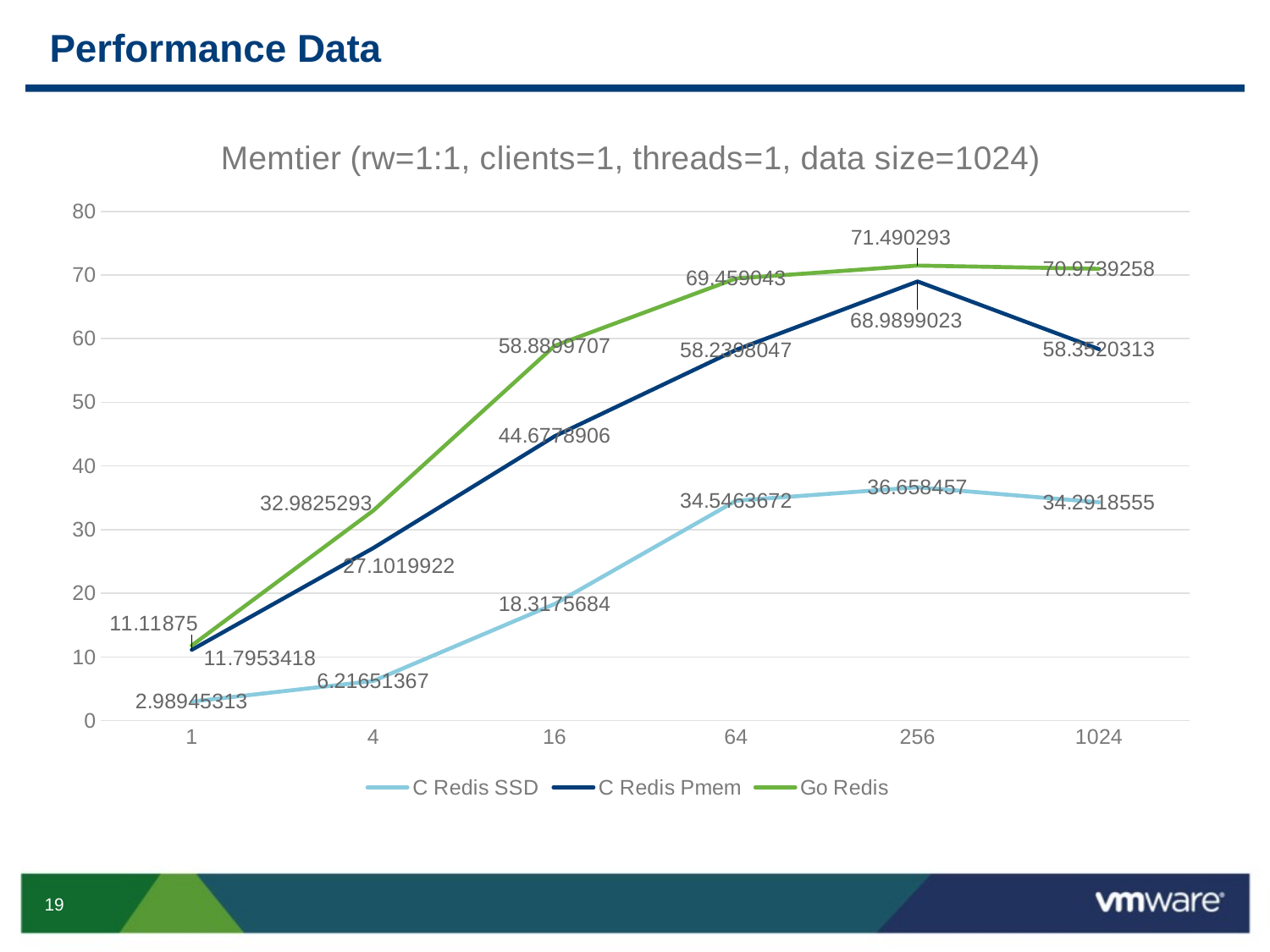
Is the value for C Redis SSD at x = 4 greater or less than 10? less What is the value for Go Redis at x = 256? 71.490293 How many series does the legend list? 3 At which x value does Go Redis reach its highest value? 256 What is the difference between the C Redis SSD values at x = 64 and x = 16? 16.2287988 At x = 256, which is larger: Go Redis or C Redis Pmem? Go Redis Does the C Redis Pmem line rise or fall from x = 256 to x = 1024? fall What is the value for C Redis SSD at x = 1? 2.98945313 What kind of chart is shown on the slide? line chart At which x value is C Redis SSD lowest? 1 How many points are plotted along the x axis for each series? 6 What is the value for C Redis Pmem at x = 256? 68.9899023